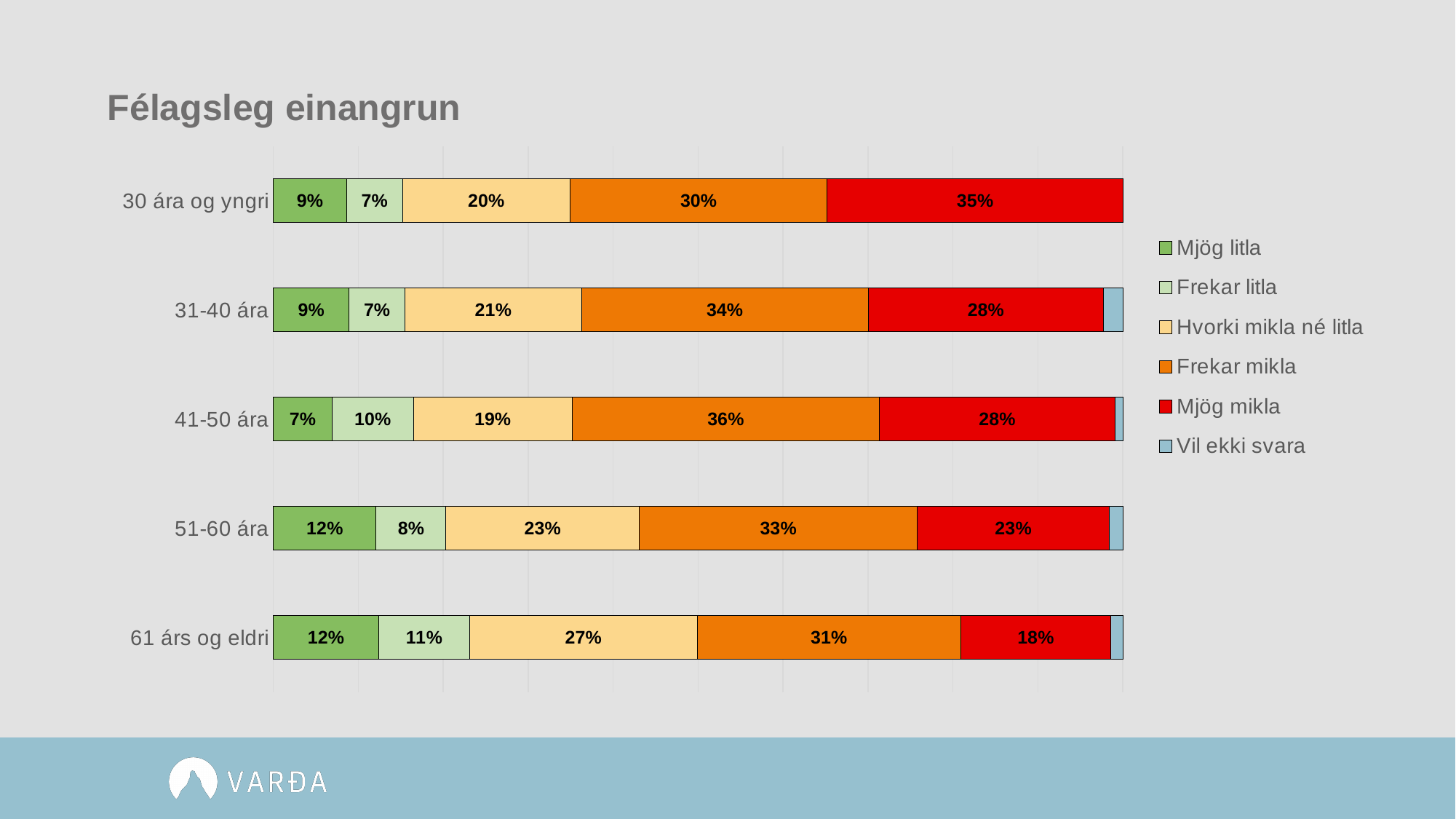
Which age group has the lowest value for "Mjög litla"? 41-50 ára How many age groups are shown in the chart? 5 What is the value for "Mjög mikla" in the "30 ára og yngri" bar? 35% What is the value for "Hvorki mikla né litla" in the "61 árs og eldri" bar? 27% What is the difference in percentage points between the "Mjög mikla" values for "30 ára og yngri" and "61 árs og eldri"? 17 percentage points How many series does the legend list? 6 Which age group has the lowest value for "Mjög mikla"? 61 árs og eldri Which age group has the highest value for "Mjög mikla"? 30 ára og yngri What is the title of the chart? Félagsleg einangrun Which is larger: the "Mjög litla" value for "51-60 ára" or for "31-40 ára"? 51-60 ára What is the value for "Frekar mikla" in the "41-50 ára" bar? 36% What kind of chart is shown on the slide? Stacked bar chart